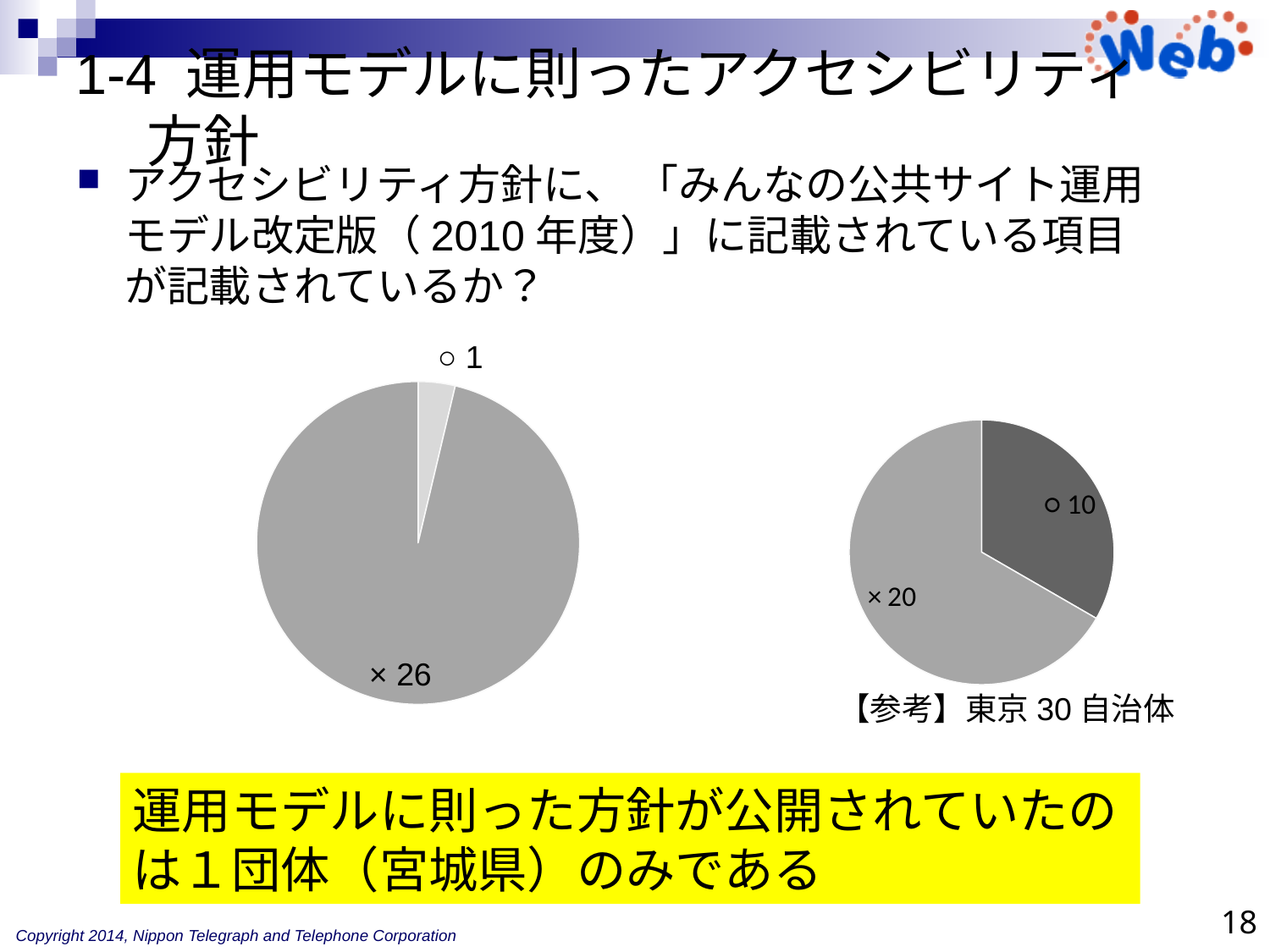
In the right pie chart (【参考】東京30自治体), what is the difference between the × value and the ○ value? 10 In the right pie chart (【参考】東京30自治体), which category has the smallest slice? ○ In the left pie chart, what is the difference between the × value and the ○ value? 25 In the right pie chart (【参考】東京30自治体), what is the value for ×? 20 In the left pie chart, what is the value for ×? 26 In the left pie chart, which category has the largest slice? × What type of chart is the right chart (【参考】東京30自治体)? pie chart Which is larger in the right pie chart (【参考】東京30自治体): the ○ value or the × value? × In the left pie chart, what is the value for ○? 1 In the right pie chart (【参考】東京30自治体), what is the value for ○? 10 What is the total of the two slices in the right pie chart (【参考】東京30自治体)? 30 How many slices does the left pie chart have? 2